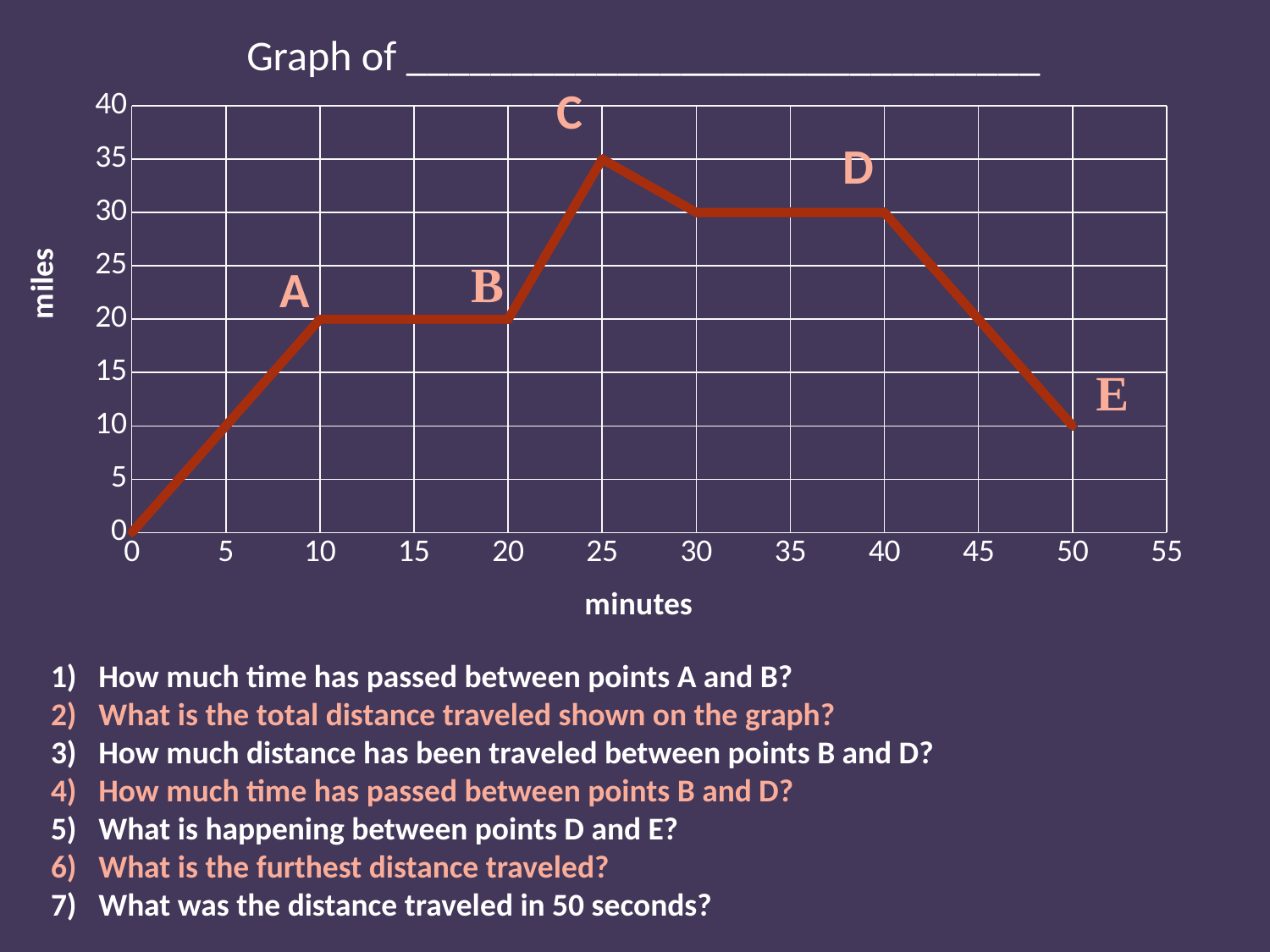
Does the line rise or fall between point D and point E? fall What kind of chart is shown on the slide? line chart What is the difference in miles between point C and point D? 5 Which labeled point has the highest value in miles? C Which is larger, the value in miles at point D or at point B? D Which labeled point has the lowest value in miles? E What is the label of the vertical axis? miles How many labeled points are marked on the line? 5 How many minutes pass between point A and point B? 10 At how many minutes does point B occur? 20 What is the value in miles at point E? 10 What is the value in miles at point C? 35